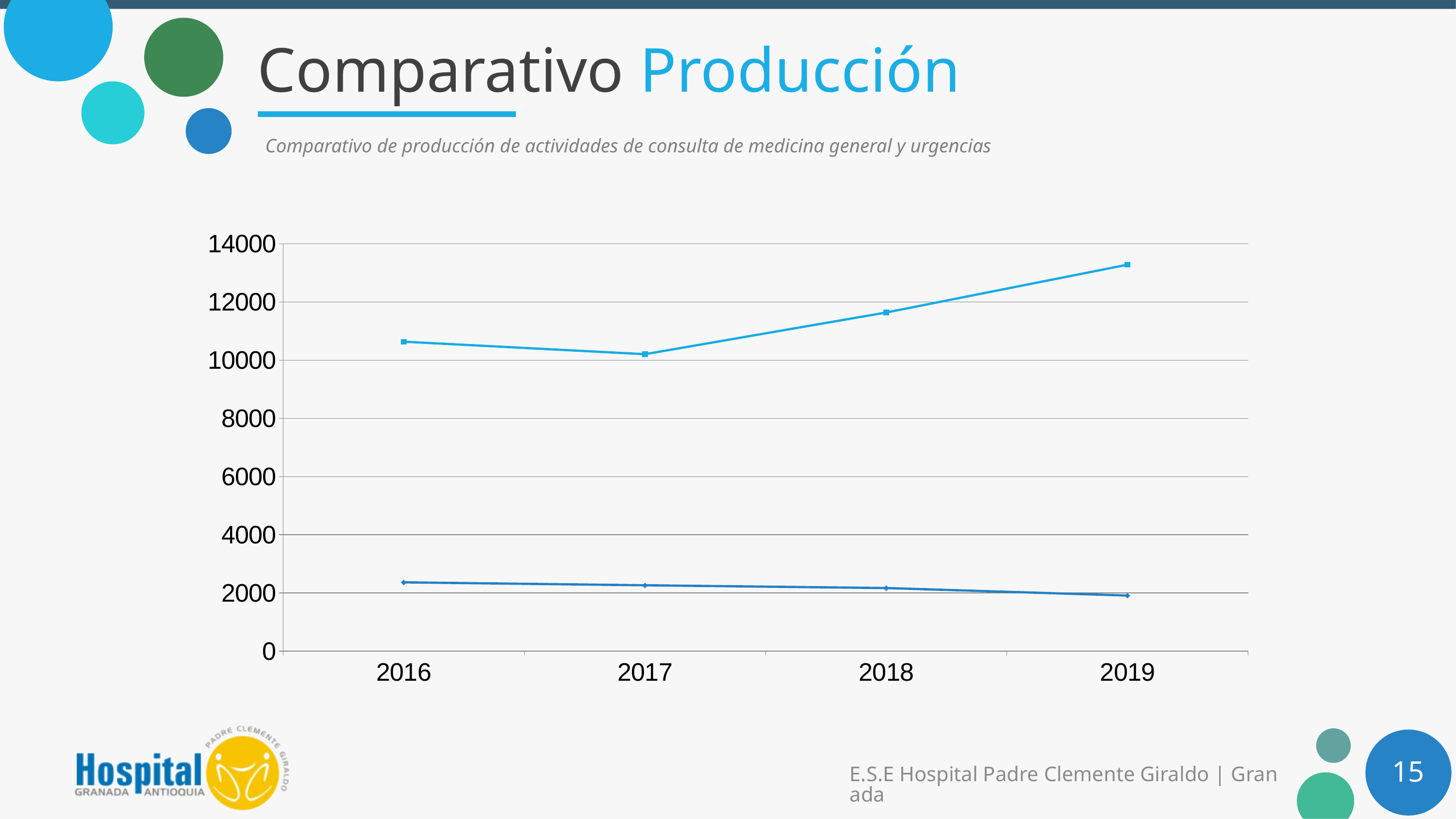
How many lines are plotted on the chart? 2 Is the value of the lower line for 2016 greater or less than 2000? greater What kind of chart is shown on the slide? line chart Which line has the larger value in 2018, the upper line or the lower line? the upper line Is the value of the upper line for 2017 greater or less than 12000? less How many years are shown on the x axis of the chart? 4 Does the lower line rise or fall from 2016 to 2019? fall Is the value of the upper line for 2019 greater or less than 12000? greater In which year does the upper line reach its highest value? 2019 In which year does the upper line reach its lowest value? 2017